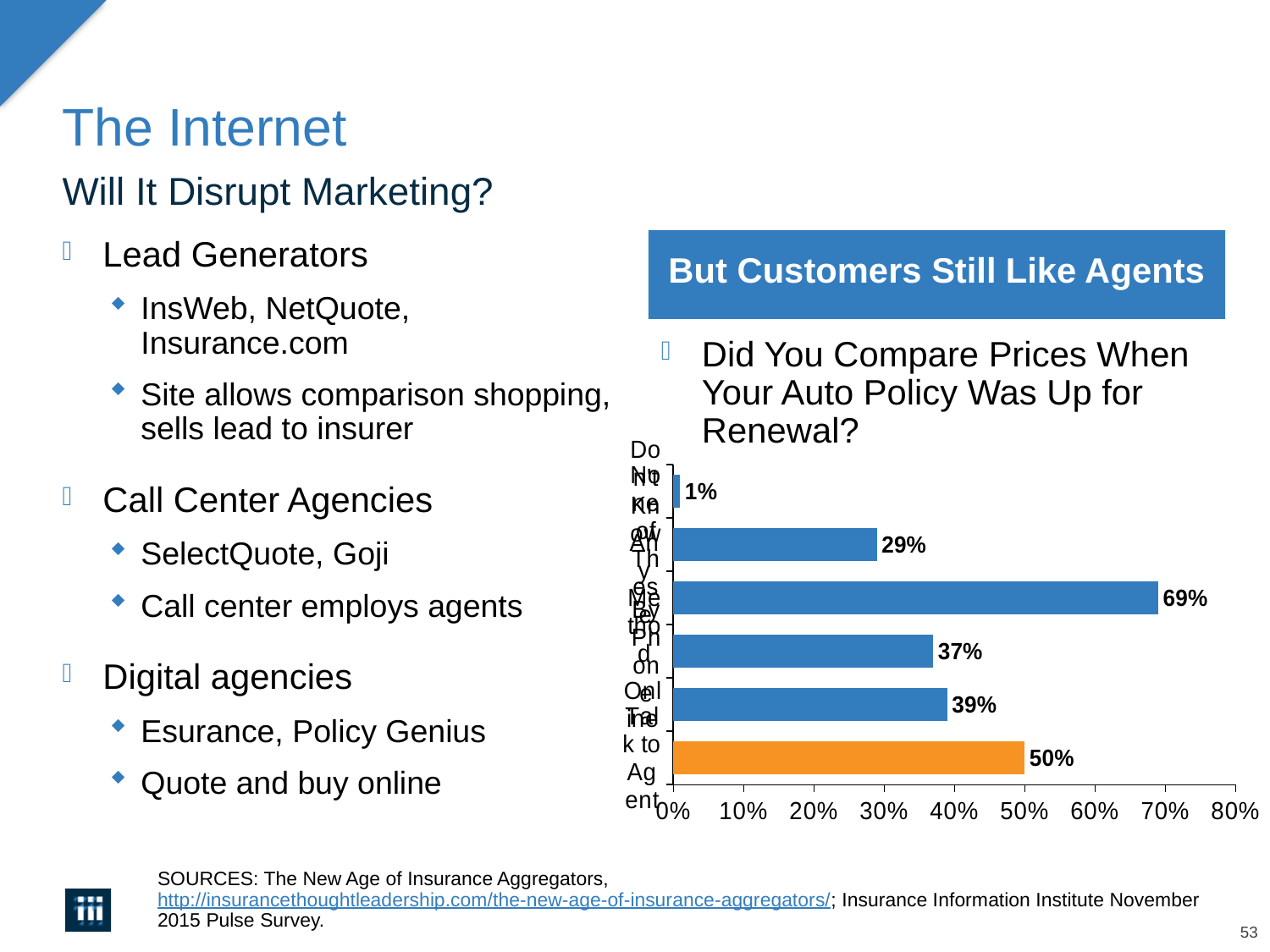
What is the highest value shown in the chart? 69% What is the difference between the highest bar (69%) and the bottom bar (50%)? 19% Which is larger, the second bar from the top or the bottom bar? the bottom bar What is the value of the bottom bar in the chart? 50% What is the value of the top bar in the chart? 1% What is the value of the third bar from the top in the chart? 69% What is the maximum value shown on the horizontal axis of the chart? 80% What is the difference between the 39% bar and the 37% bar? 2% How many bars are plotted in the chart? 6 What is the lowest value shown in the chart? 1% What colour is the bottom bar in the chart? orange What type of chart is shown on the slide? bar chart